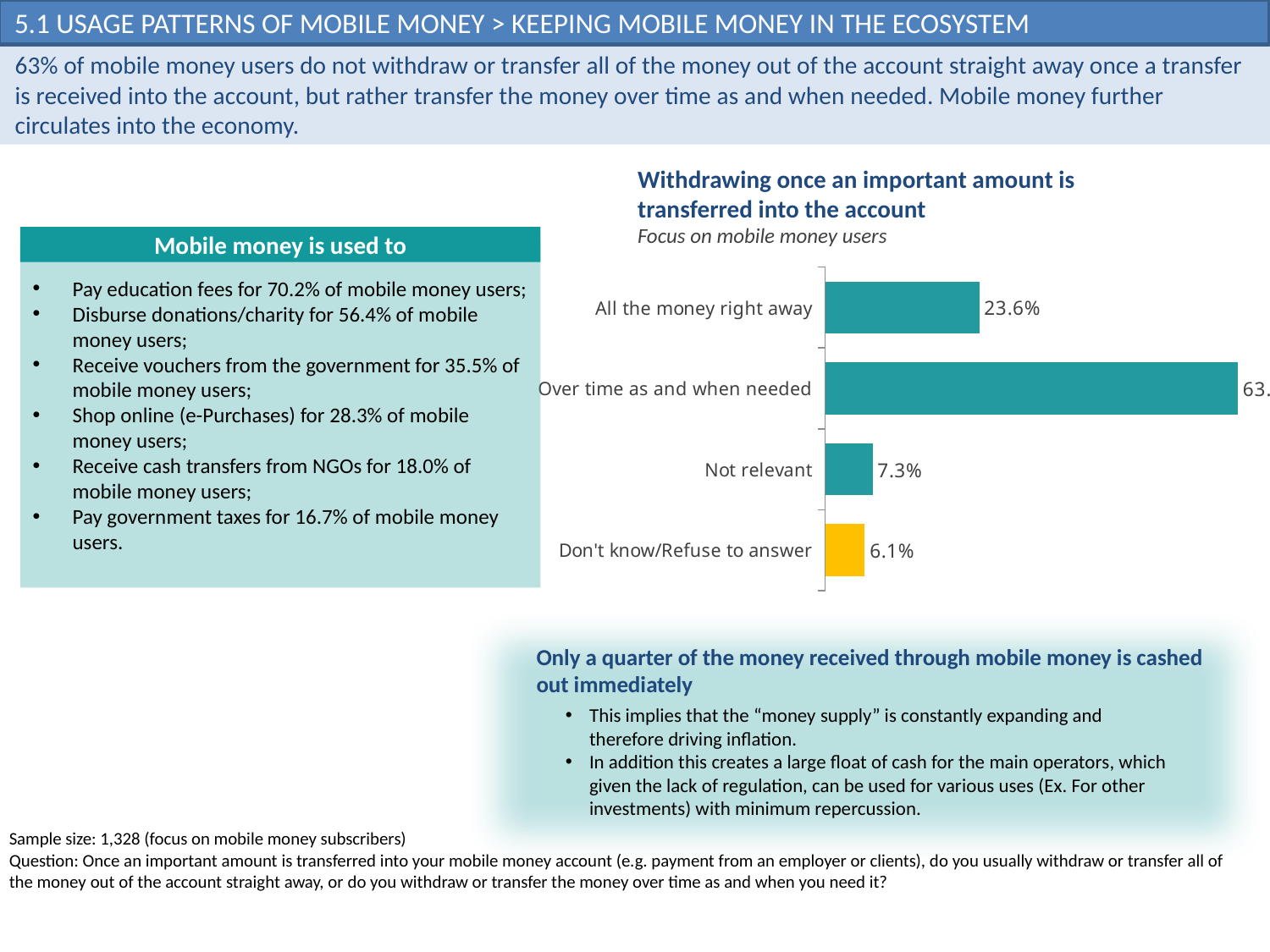
Which category has the lowest value? Don't know/Refuse to answer What is the difference between "All the money right away" and "Not relevant"? 16.3% What is the title of the chart? Withdrawing once an important amount is transferred into the account What kind of chart is shown on the slide? bar chart What is the value for "Not relevant"? 7.3% What is the value for "Don't know/Refuse to answer"? 6.1% Which category has the highest value? Over time as and when needed What is the difference between "Not relevant" and "Don't know/Refuse to answer"? 1.2% What is the value for "All the money right away"? 23.6% Which is larger, "All the money right away" or "Not relevant"? All the money right away How many categories are shown in the chart? 4 Which category's bar is coloured yellow rather than teal? Don't know/Refuse to answer